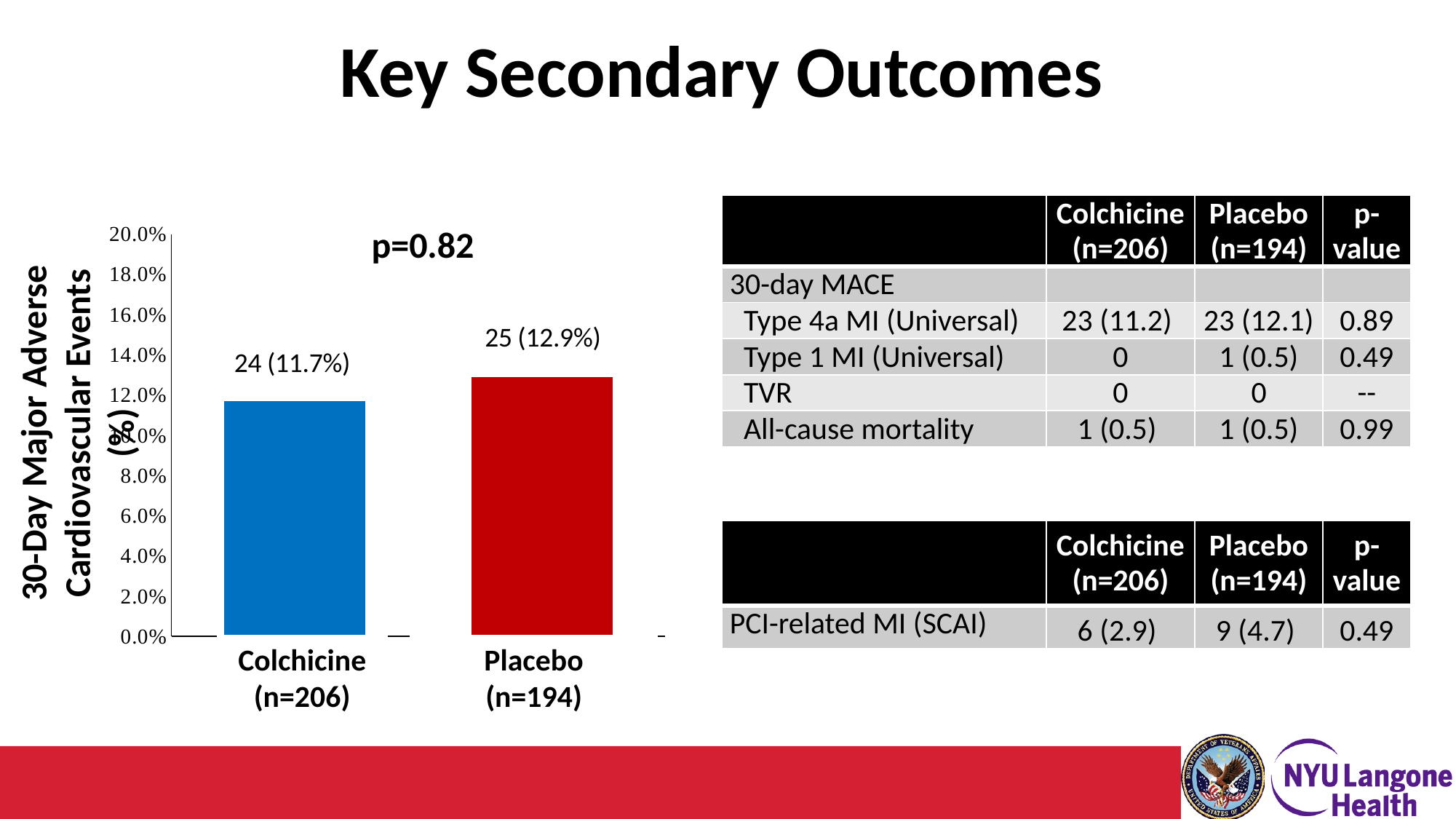
Is the 30-day MACE rate for Placebo greater or less than 12.0%? greater What is the difference in percentage points between the Placebo and Colchicine 30-day MACE rates? 1.2% What is the data label shown on the Placebo bar? 25 (12.9%) What type of chart is shown on the slide? Bar chart Is the 30-day MACE rate for Colchicine greater or less than 12.0%? less Which group has the lower 30-day MACE rate in the bar chart? Colchicine Which group has the higher 30-day MACE rate in the bar chart? Placebo What p-value is annotated above the bars in the chart? p=0.82 What percentage of 30-day major adverse cardiovascular events is shown for the Placebo group? 12.9% What is the maximum value shown on the chart's y-axis? 20.0% How many bars are plotted in the chart? 2 What is the data label shown on the Colchicine bar? 24 (11.7%)